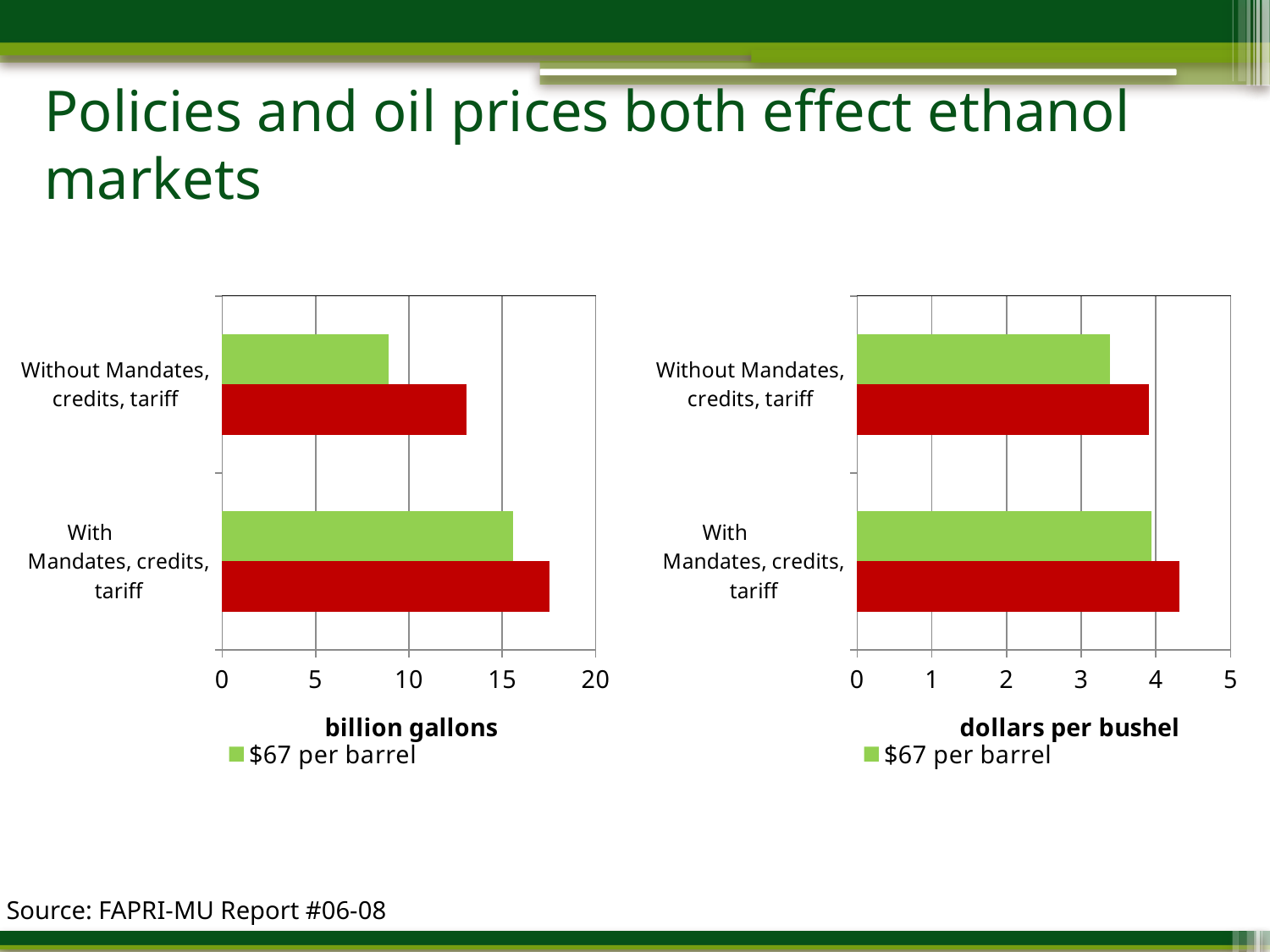
What kind of chart is the left chart (billion gallons)? bar chart How many categories are shown on the left chart (billion gallons)? 2 On the left chart (billion gallons), is the $67 per barrel value for "Without Mandates, credits, tariff" greater or less than 10? less What is the x-axis label of the right chart? dollars per bushel What is the x-axis label of the left chart? billion gallons On the right chart (dollars per bushel), which category has the higher $67 per barrel value: "With Mandates, credits, tariff" or "Without Mandates, credits, tariff"? With Mandates, credits, tariff On the left chart (billion gallons), which category has the highest $67 per barrel value? With Mandates, credits, tariff On the left chart (billion gallons), is the $67 per barrel value for "With Mandates, credits, tariff" greater or less than 10? greater On the right chart (dollars per bushel), is the red bar for "With Mandates, credits, tariff" greater or less than 4? greater On the left chart (billion gallons), which category has the higher $67 per barrel value: "With Mandates, credits, tariff" or "Without Mandates, credits, tariff"? With Mandates, credits, tariff